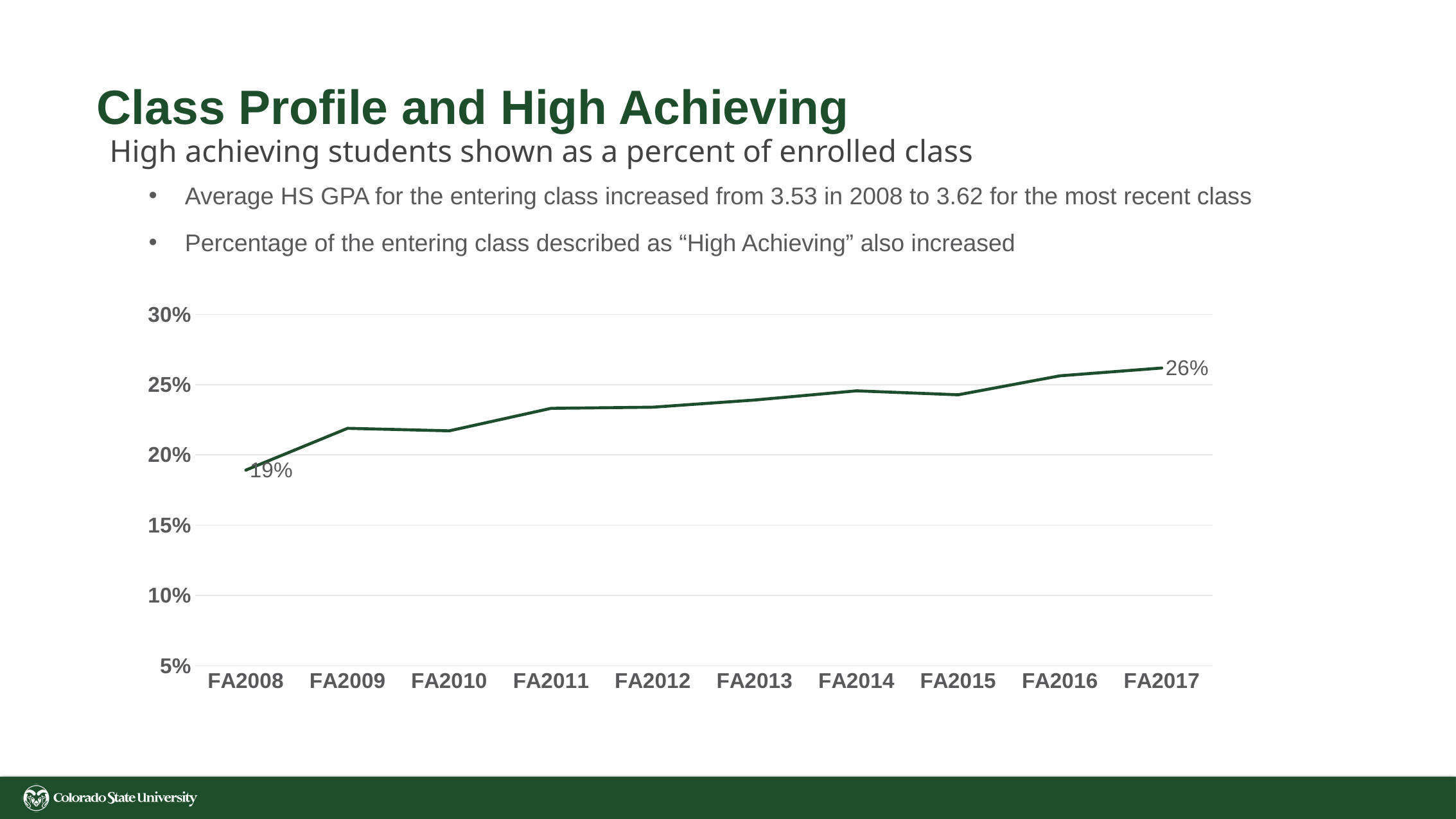
What kind of chart is shown on the slide? line chart Is the value for FA2012 greater or less than 25%? less Which year has the highest value? FA2017 Is the value for FA2009 greater or less than 20%? greater Which is larger, the value for FA2015 or the value for FA2016? FA2016 Which year has the lowest value? FA2008 What is the value for FA2008? 19% Do the values generally rise or fall from FA2008 to FA2017? rise What is the difference between the values for FA2017 and FA2008? 7 percentage points What colour is the plotted line? dark green What is the value for FA2017? 26% How many years are plotted on the x axis? 10